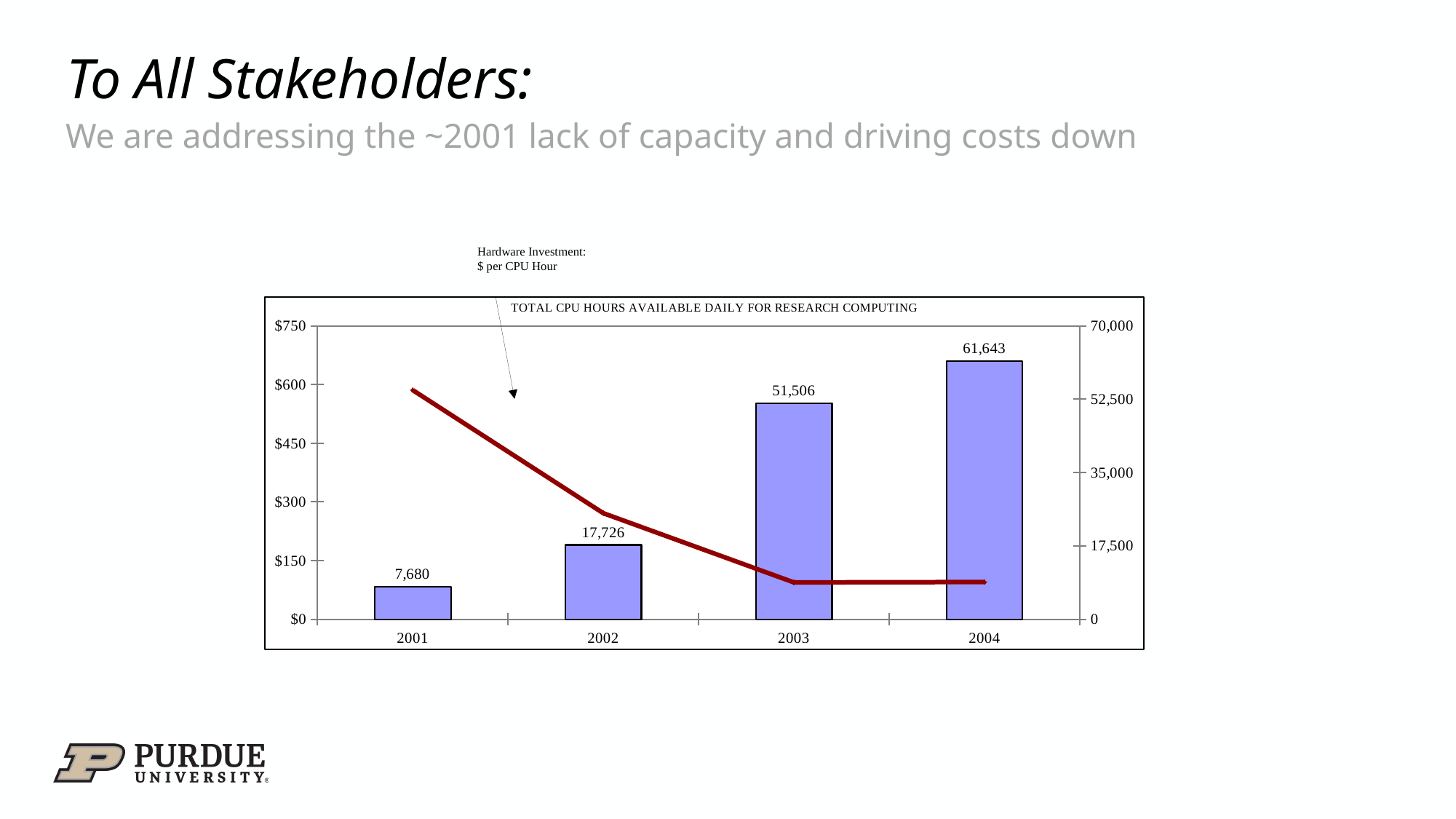
What is the total CPU hours available daily for research computing in 2002? 17,726 Is the hardware investment in $ per CPU hour for 2001 greater or less than $450? greater What is the difference in total CPU hours available daily between 2004 and 2003? 10,137 What is the total CPU hours available daily for research computing in 2001? 7,680 Which year has the highest total CPU hours available daily? 2004 What is the total CPU hours available daily for research computing in 2004? 61,643 What is the difference in total CPU hours available daily between 2002 and 2001? 10,046 Does the hardware investment in $ per CPU hour line rise or fall from 2001 to 2003? fall Which year has the lowest total CPU hours available daily? 2001 Which year has more total CPU hours available daily, 2002 or 2003? 2003 How many years are shown on the x axis of the chart? 4 Is the hardware investment in $ per CPU hour for 2003 greater or less than $150? less